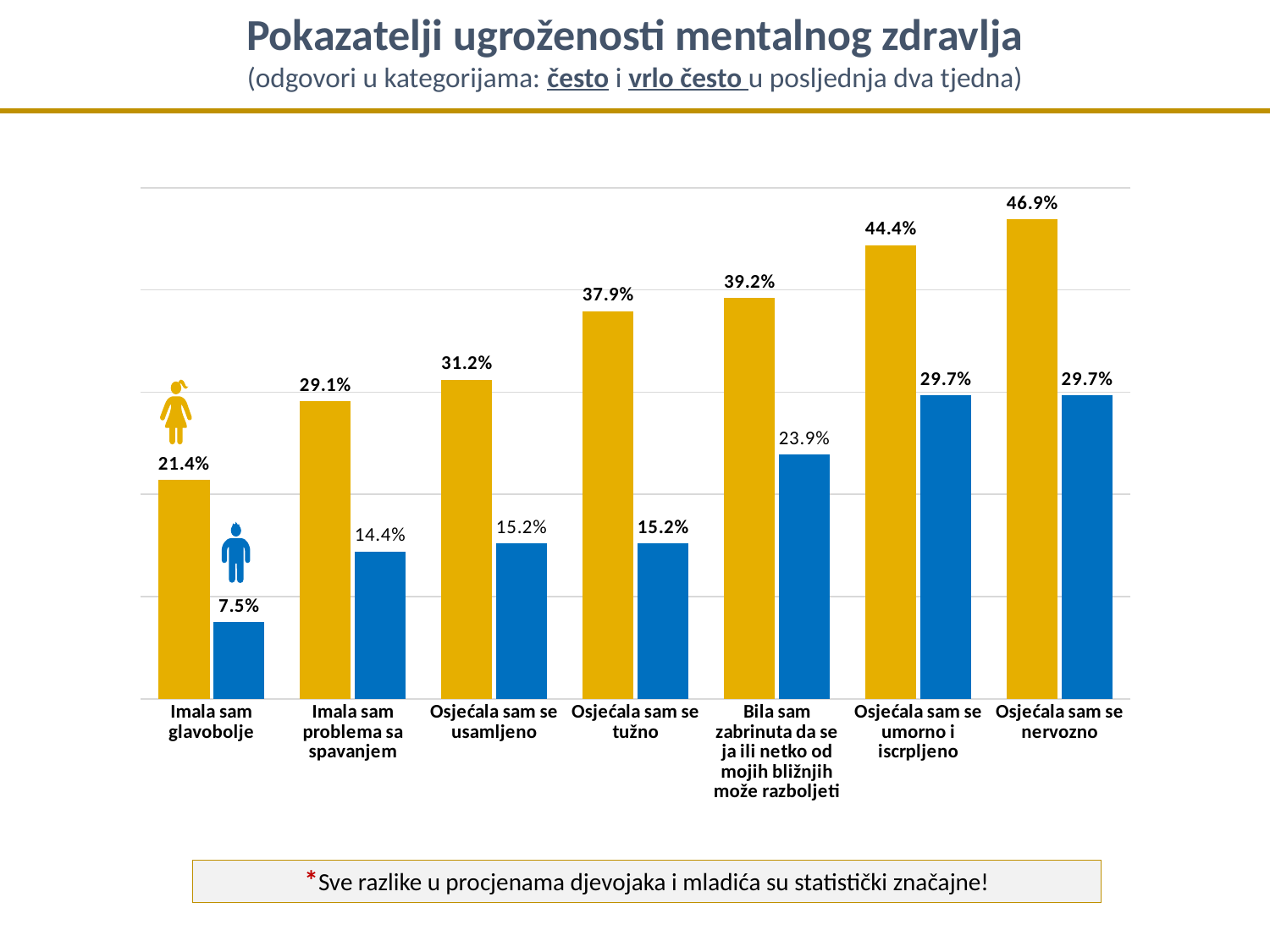
Which is larger: the yellow bar for "Imala sam problema sa spavanjem" or the yellow bar for "Osjećala sam se usamljeno"? Osjećala sam se usamljeno Do the yellow bars rise or fall from left to right across the categories? Rise How many categories are shown on the x axis? 7 What is the value of the blue bar for "Bila sam zabrinuta da se ja ili netko od mojih bližnjih može razboljeti"? 23.9% What is the value of the blue (boys) bar for "Imala sam glavobolje"? 7.5% What is the difference between the yellow bars for "Osjećala sam se nervozno" and "Imala sam glavobolje"? 25.5% What is the difference between the yellow and blue bars for "Osjećala sam se umorno i iscrpljeno"? 14.7% What is the value of the yellow (girls) bar for "Imala sam glavobolje"? 21.4% Which category has the lowest blue bar? Imala sam glavobolje What kind of chart is shown on the slide? Bar chart Which category has the highest yellow bar? Osjećala sam se nervozno What is the value of the yellow bar for "Osjećala sam se tužno"? 37.9%